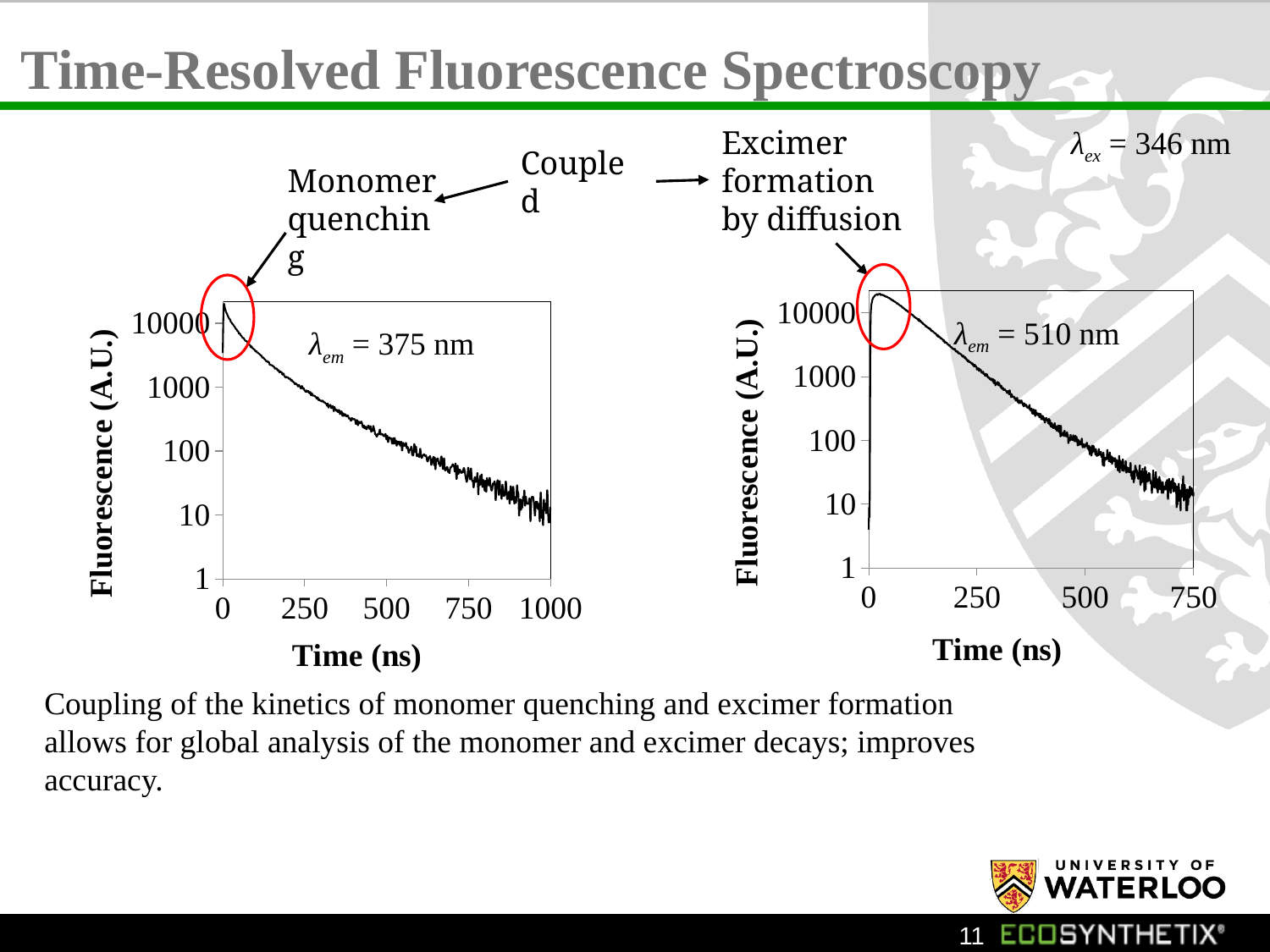
What is the x-axis label of the right chart (λem = 510 nm)? Time (ns) What kind of chart is the right chart (λem = 510 nm)? line chart In the right chart (λem = 510 nm), after the initial peak, does the fluorescence rise or fall as time increases? fall In the right chart (λem = 510 nm), is the peak fluorescence value greater or less than 1000? greater In the left chart (λem = 375 nm), is the peak fluorescence value near 0 ns greater or less than 1000? greater What kind of chart is the left chart (λem = 375 nm)? line chart In the right chart (λem = 510 nm), is the fluorescence value at 750 ns greater or less than 100? less In the left chart (λem = 375 nm), what is the largest tick value shown on the x axis? 1000 What is the y-axis label of the left chart (λem = 375 nm)? Fluorescence (A.U.) How many data series are plotted in the left chart (λem = 375 nm)? 1 In the left chart (λem = 375 nm), does the fluorescence rise or fall as time increases along the x axis? fall